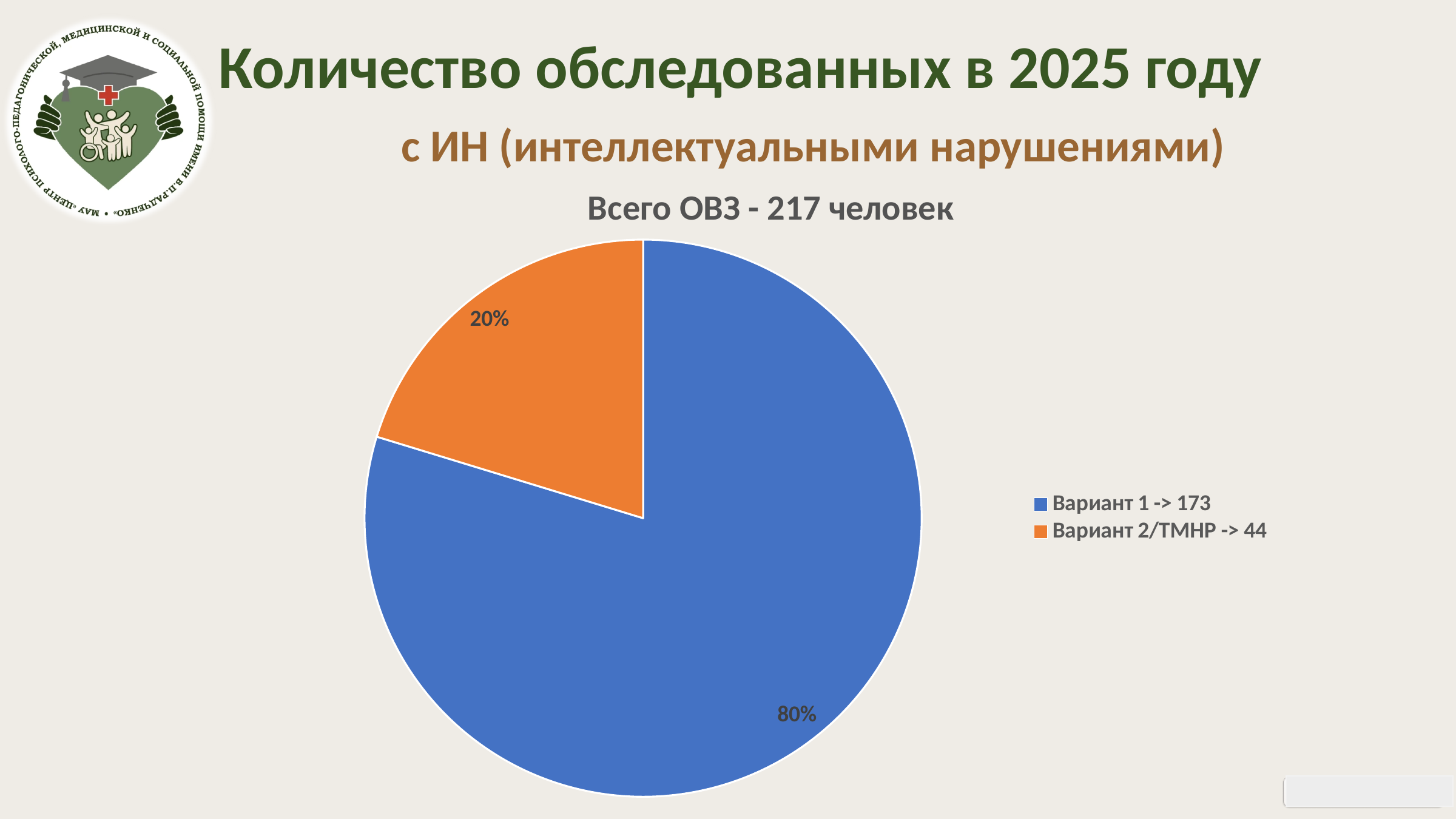
How many people does the legend give for Вариант 2/ТМНР? 44 How many slices does the pie chart have? 2 What colour is the slice for Вариант 2/ТМНР? orange Which is larger, the share for Вариант 1 or for Вариант 2/ТМНР? Вариант 1 Which category has the smallest slice of the pie? Вариант 2/ТМНР What percentage share does the slice for Вариант 2/ТМНР have? 20% How many people does the legend give for Вариант 1? 173 What is the chart's title? Всего ОВЗ - 217 человек Which category has the largest slice of the pie? Вариант 1 What is the difference in people between Вариант 1 and Вариант 2/ТМНР? 129 What percentage share does the slice for Вариант 1 have? 80% What kind of chart is shown on the slide? pie chart